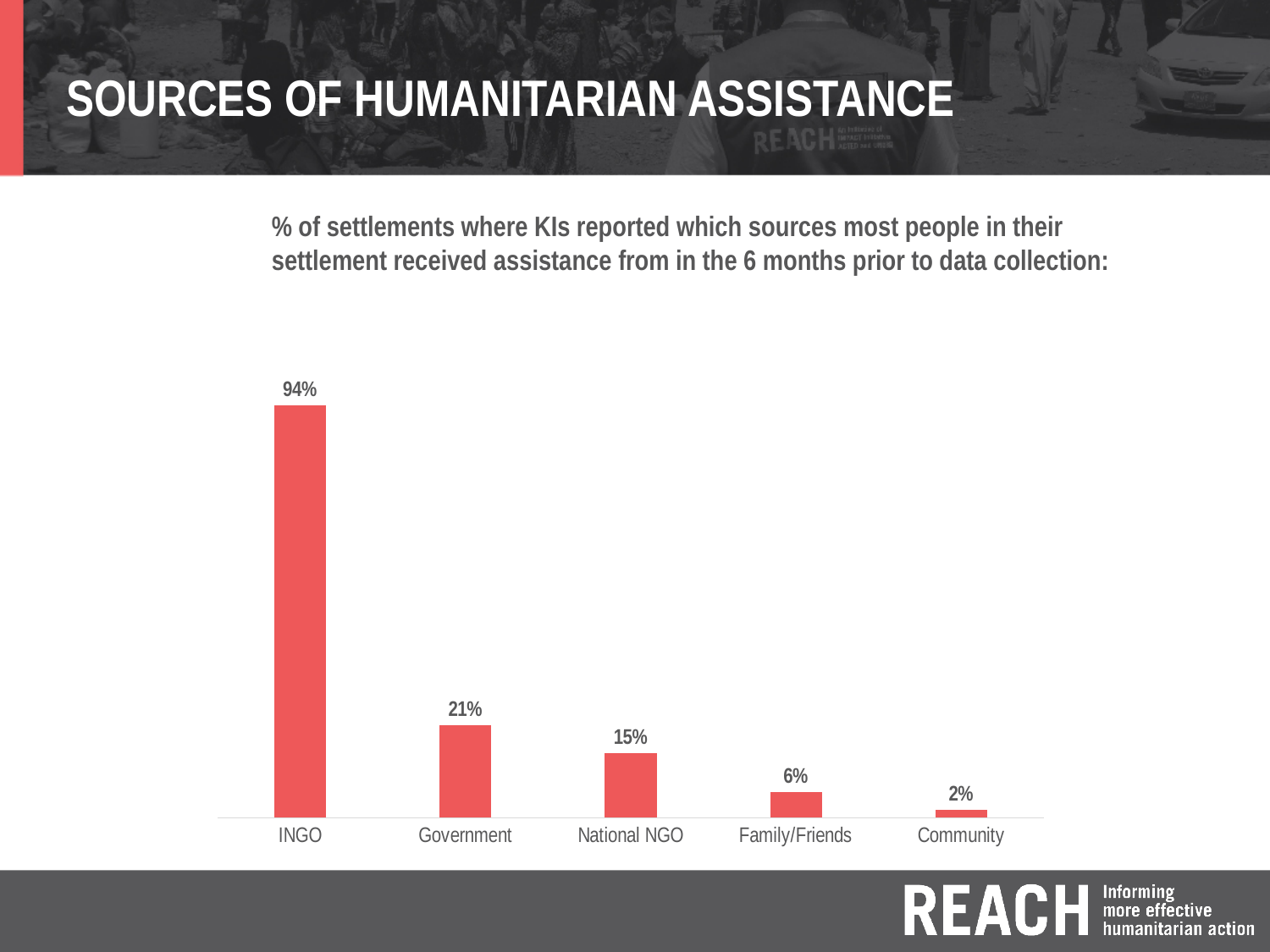
What type of chart is shown on the slide? Bar chart Which is larger, the value for Government or the value for National NGO? Government What is the difference between the values for National NGO and Family/Friends? 9% What is the value shown for National NGO? 15% Which source of assistance has the lowest percentage of settlements? Community Which source of assistance has the highest percentage of settlements? INGO What is the value shown for Government? 21% What percentage of settlements reported receiving assistance from INGOs? 94% What is the value shown for Community? 2% How many sources of assistance are shown in the chart? 5 What is the value shown for Family/Friends? 6% What is the difference between the values for INGO and Government? 73%